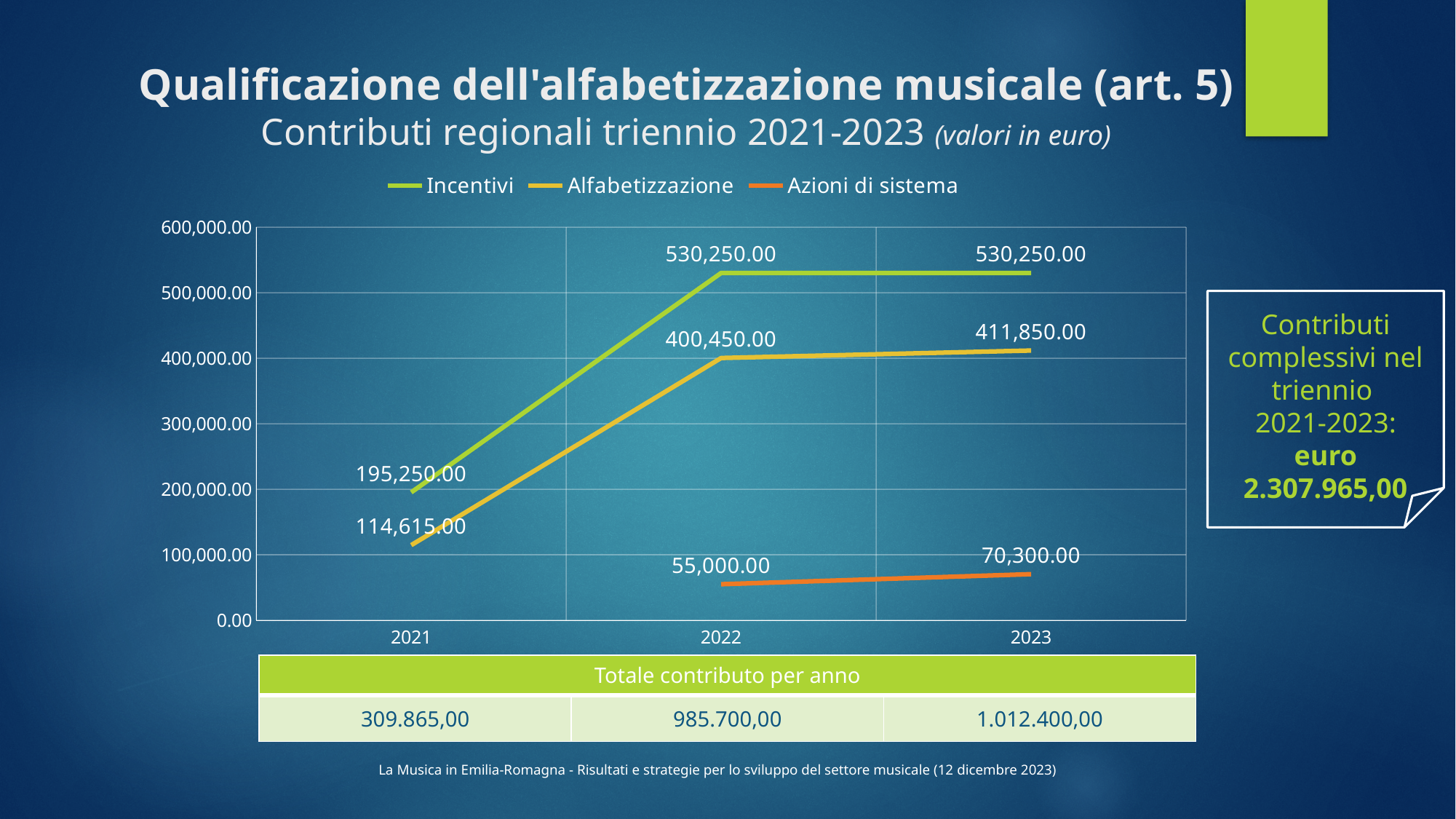
What is the value for Incentivi in 2022? 530,250.00 What is the difference between the Incentivi values for 2022 and 2021? 335,000.00 What kind of chart is shown on the slide? line chart How many series does the legend list? 3 How many years are shown on the x axis? 3 Which series has the highest value in 2023? Incentivi Which series has the lowest value in 2022? Azioni di sistema What is the value for Alfabetizzazione in 2023? 411,850.00 What is the value for Azioni di sistema in 2023? 70,300.00 Which is larger: Alfabetizzazione in 2022 or Azioni di sistema in 2022? Alfabetizzazione in 2022 Does the Alfabetizzazione series rise or fall from 2021 to 2023? rise What is the value for Alfabetizzazione in 2021? 114,615.00